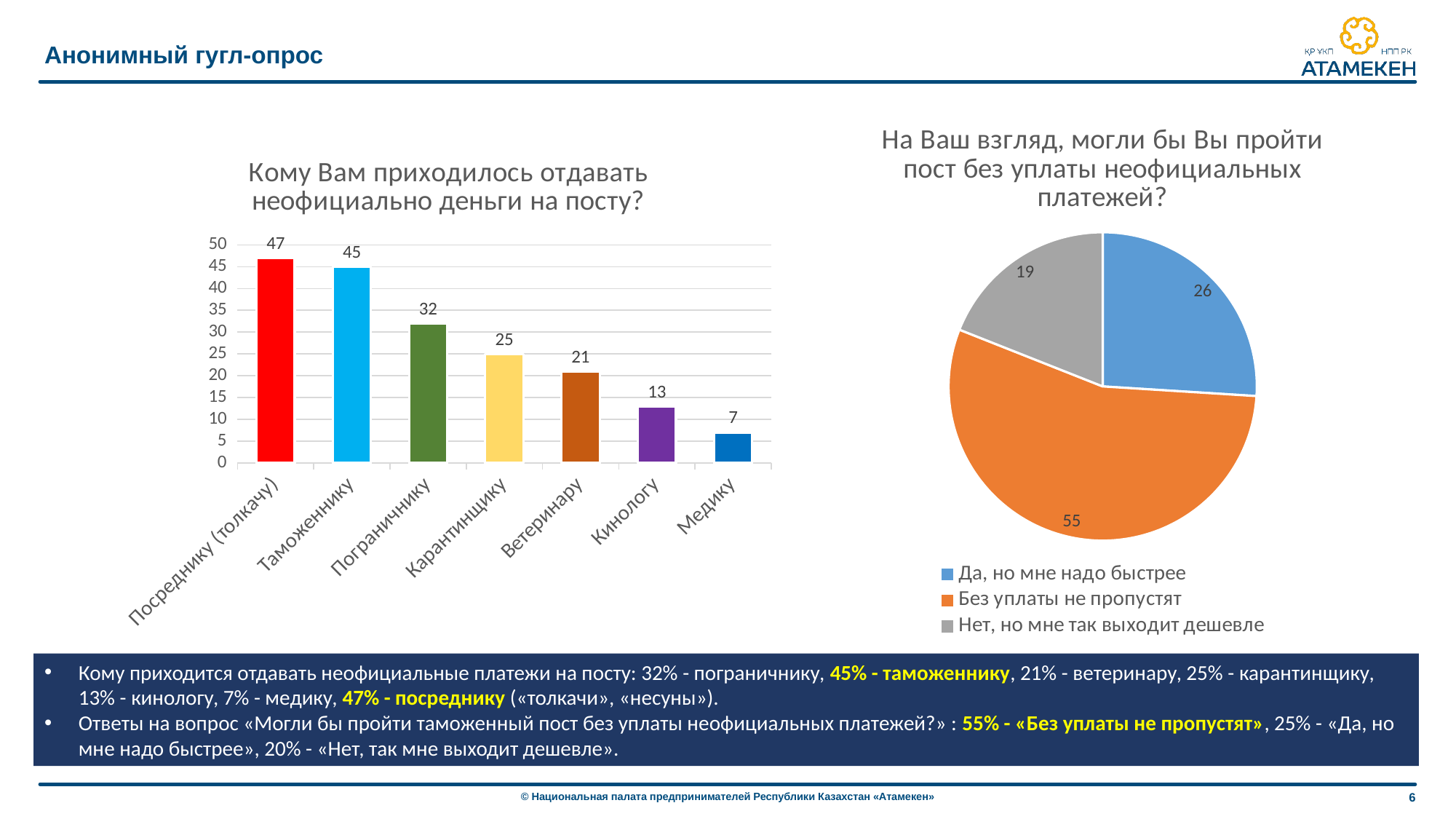
In the pie chart 'На Ваш взгляд, могли бы Вы пройти пост без уплаты неофициальных платежей?', what is the value for 'Да, но мне надо быстрее'? 26 How many categories are shown in the bar chart on the left? 7 How many entries does the legend of the pie chart on the right list? 3 In the pie chart on the right, which slice is the largest? Без уплаты не пропустят In the bar chart on the left, what is the difference between the values for Пограничнику and Кинологу? 19 In the bar chart on the left, do the values rise or fall from left to right along the x axis? Fall In the bar chart on the left, which category has the highest value? Посреднику (толкачу) What kind of chart is the chart on the left of the slide? Bar chart In the bar chart on the left, which category has the lowest value? Медику In the bar chart 'Кому Вам приходилось отдавать неофициально деньги на посту?', what is the value for Ветеринару? 21 In the bar chart 'Кому Вам приходилось отдавать неофициально деньги на посту?', what is the value for Таможеннику? 45 In the bar chart on the left, which is larger: the value for Карантинщику or the value for Ветеринару? Карантинщику